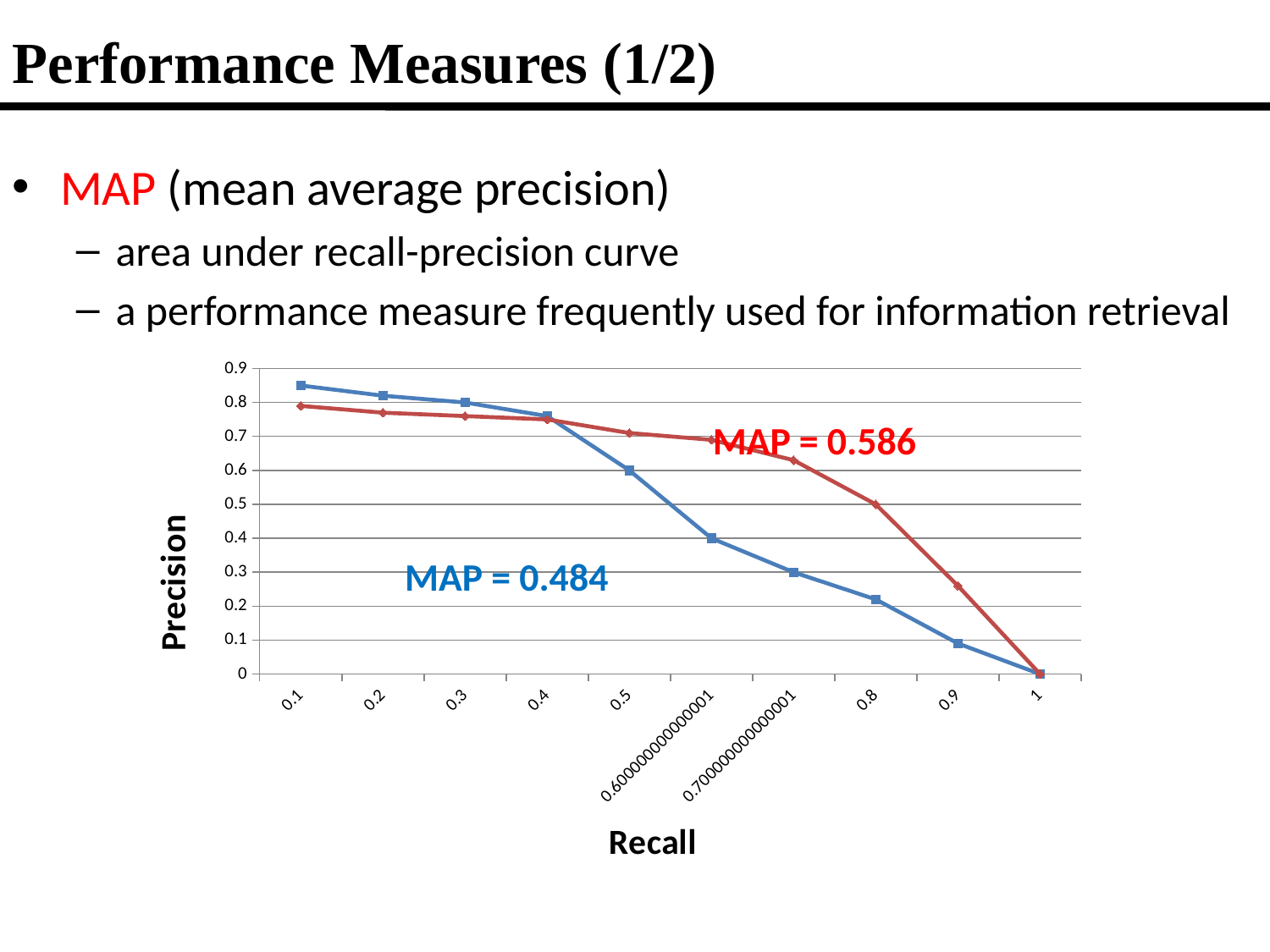
Is the precision of the red line at recall 0.9 greater or less than 0.2? greater What is the precision of both lines at recall 1? 0 Which line has the higher MAP value, the red line or the blue line? red line At recall 0.8, which line has the higher precision, the red line or the blue line? red line How many recall values are marked along the x axis? 10 Is the precision of the blue line at recall 0.1 greater or less than 0.8? greater What is the difference between the two MAP values printed on the chart? 0.102 Do the precision values rise or fall as recall increases along the x axis? fall What is the title of the y axis? Precision What kind of chart is shown on the slide? line chart What is the MAP value printed next to the red line? 0.586 What is the MAP value printed next to the blue line? 0.484